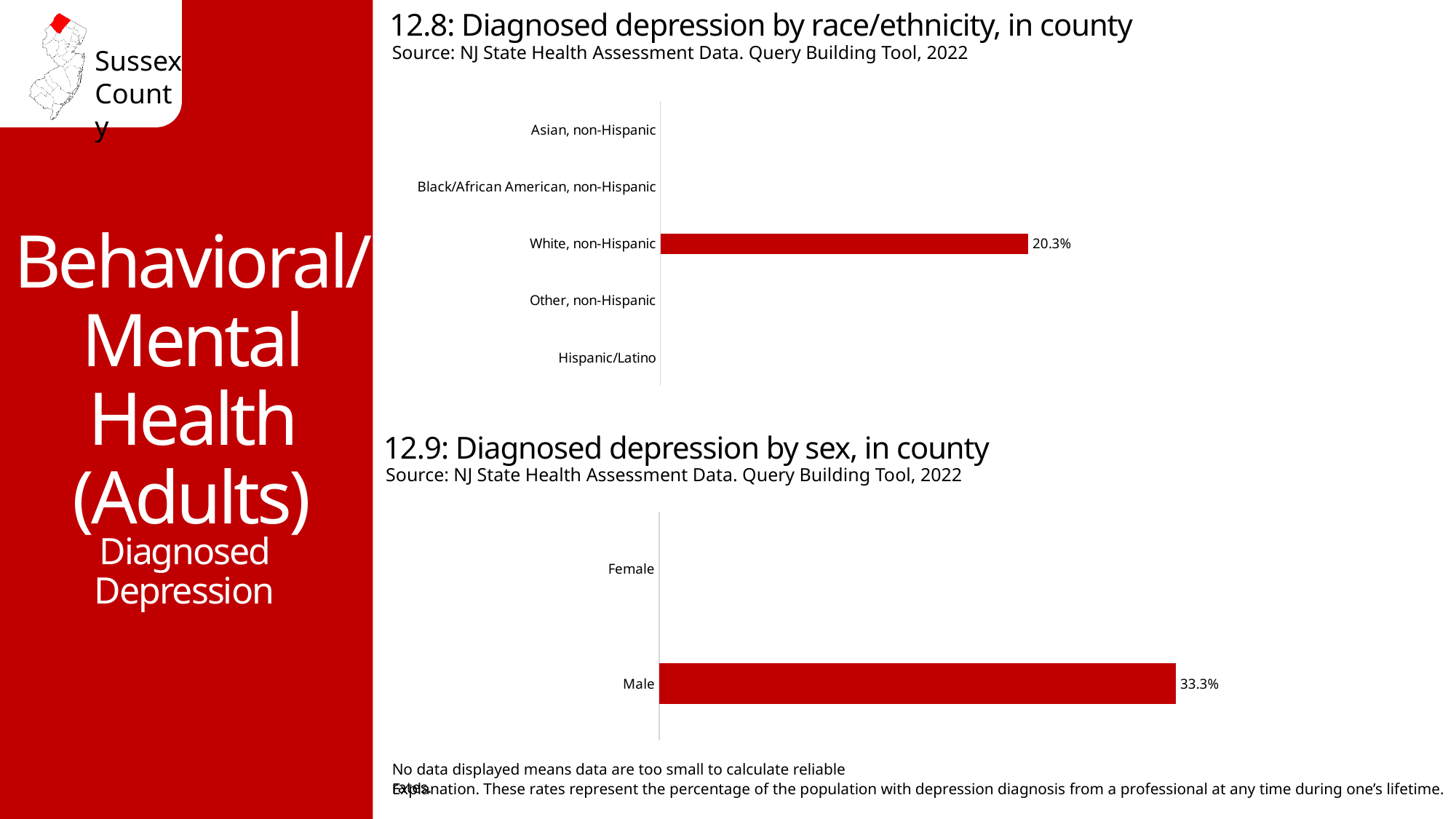
In the chart '12.8: Diagnosed depression by race/ethnicity, in county', which category has the highest value shown? White, non-Hispanic In the chart '12.9: Diagnosed depression by sex, in county', what is the value for Male? 33.3% Is the value for Male in the chart '12.9: Diagnosed depression by sex, in county' larger than the value for White, non-Hispanic in the chart '12.8: Diagnosed depression by race/ethnicity, in county'? Yes What source is cited for the chart '12.8: Diagnosed depression by race/ethnicity, in county'? NJ State Health Assessment Data. Query Building Tool, 2022 What is the difference between the Male value in chart 12.9 and the White, non-Hispanic value in chart 12.8? 13 percentage points How many categories are listed on the axis of the chart '12.9: Diagnosed depression by sex, in county'? 2 What kind of chart is '12.8: Diagnosed depression by race/ethnicity, in county'? Bar chart How many race/ethnicity categories are listed on the axis of the chart '12.8: Diagnosed depression by race/ethnicity, in county'? 5 What colour are the bars in the two charts on the slide? Red In the chart '12.8: Diagnosed depression by race/ethnicity, in county', what is the value for White, non-Hispanic? 20.3% What kind of chart is '12.9: Diagnosed depression by sex, in county'? Bar chart In the chart '12.9: Diagnosed depression by sex, in county', which category has a bar displayed? Male